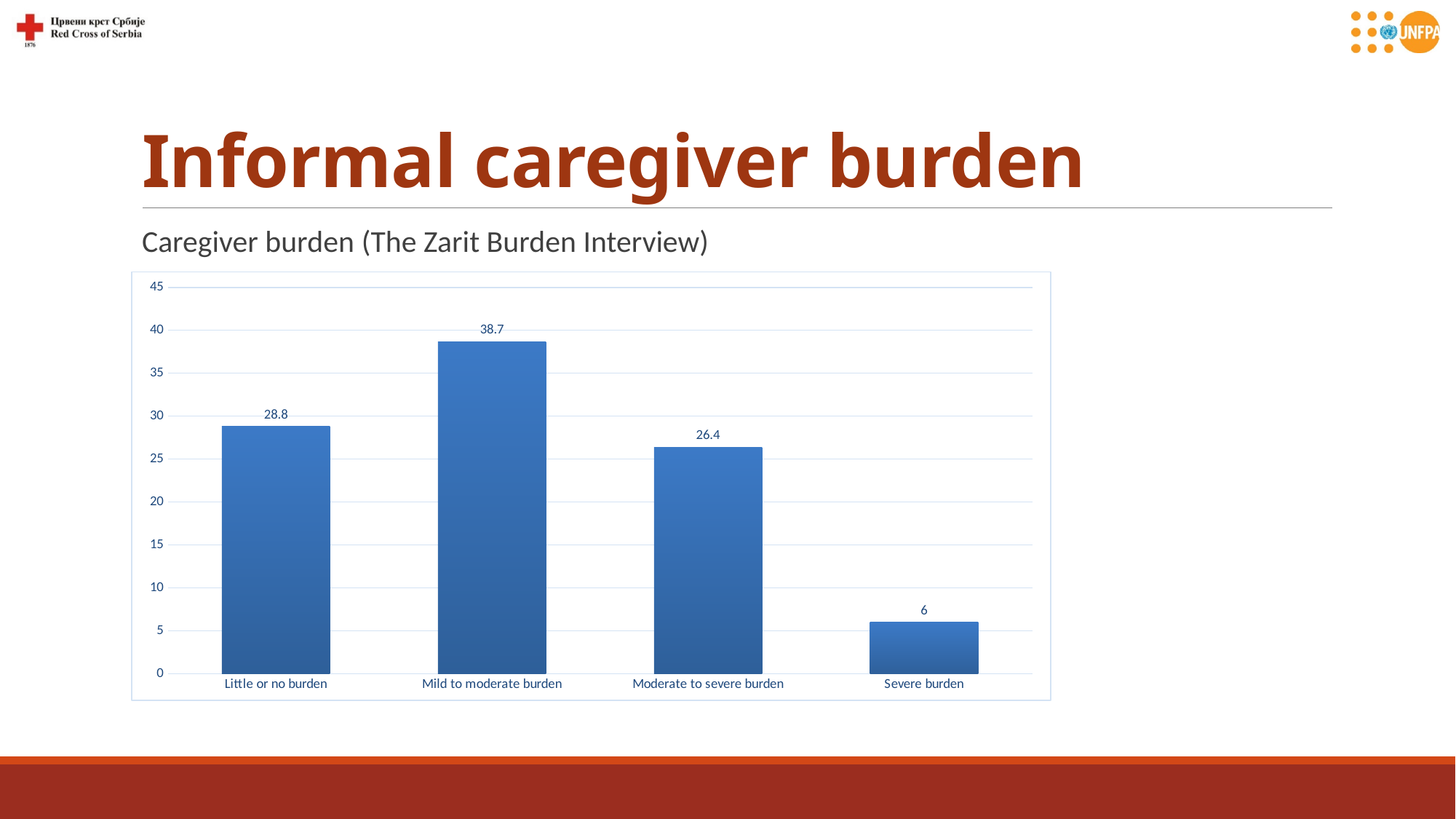
What is the value for Mild to moderate burden? 38.7 Which is larger, the value for Little or no burden or the value for Moderate to severe burden? Little or no burden What is the highest value shown on the y axis? 45 Which category has the lowest value? Severe burden How many categories are shown on the x axis? 4 What is the value for Little or no burden? 28.8 What is the difference between the values for Mild to moderate burden and Moderate to severe burden? 12.3 What is the difference between the values for Little or no burden and Severe burden? 22.8 What kind of chart is shown on the slide? bar chart Is the value for Moderate to severe burden greater or less than 25? greater Which category has the highest value? Mild to moderate burden What is the value for Severe burden? 6